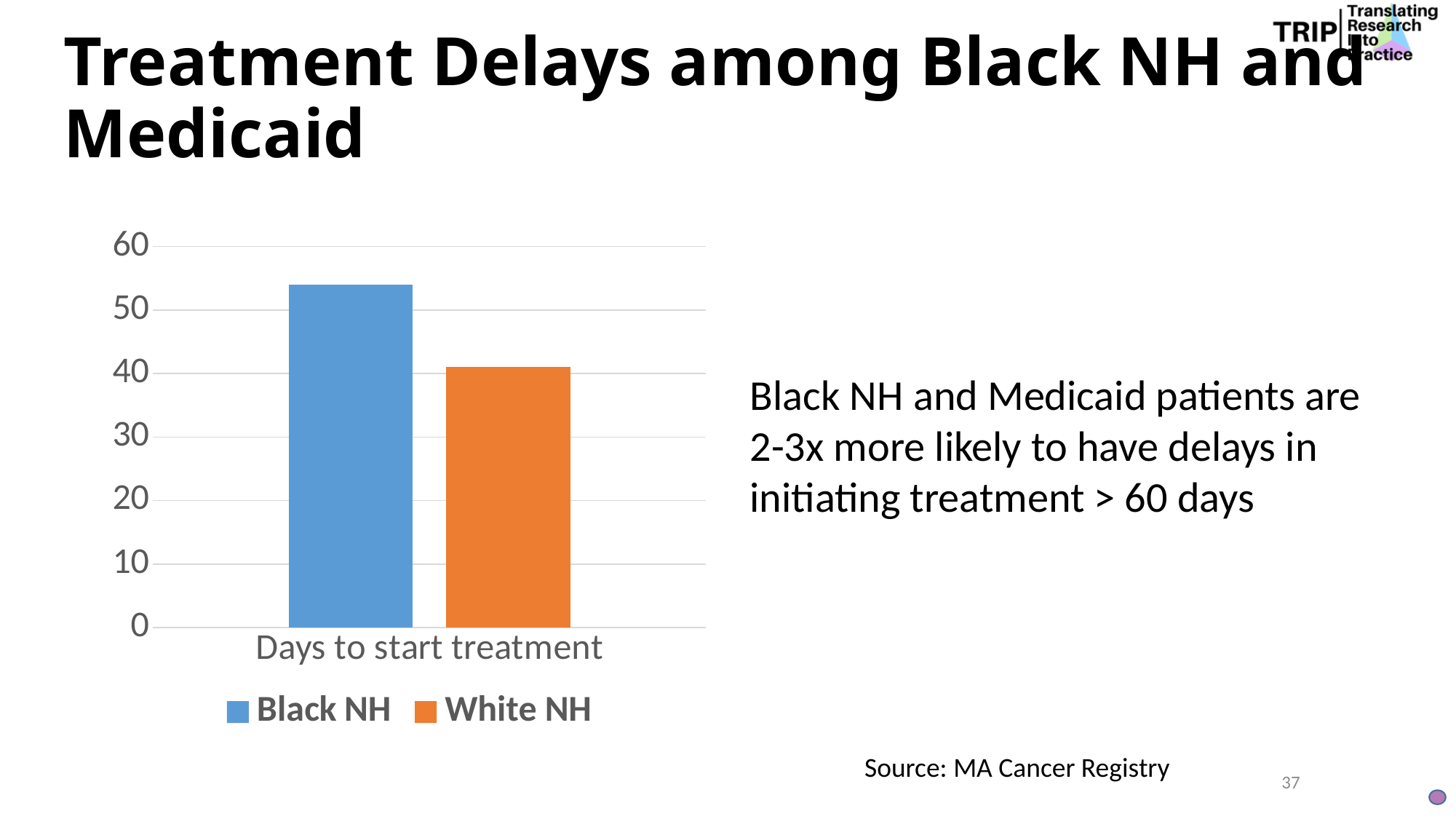
Is the value for White NH greater or less than 50? less Which series has the shortest bar in the chart? White NH Which series has the higher value for Days to start treatment, Black NH or White NH? Black NH Is the value for White NH greater or less than 30? greater How many categories are shown on the x axis of the chart? 1 Which series has the tallest bar in the chart? Black NH How many series does the chart legend list? 2 Is the value for Black NH greater or less than 60? less What colour is the bar for White NH in the chart? orange What is the category label shown on the x axis of the chart? Days to start treatment What kind of chart is shown on the slide? bar chart